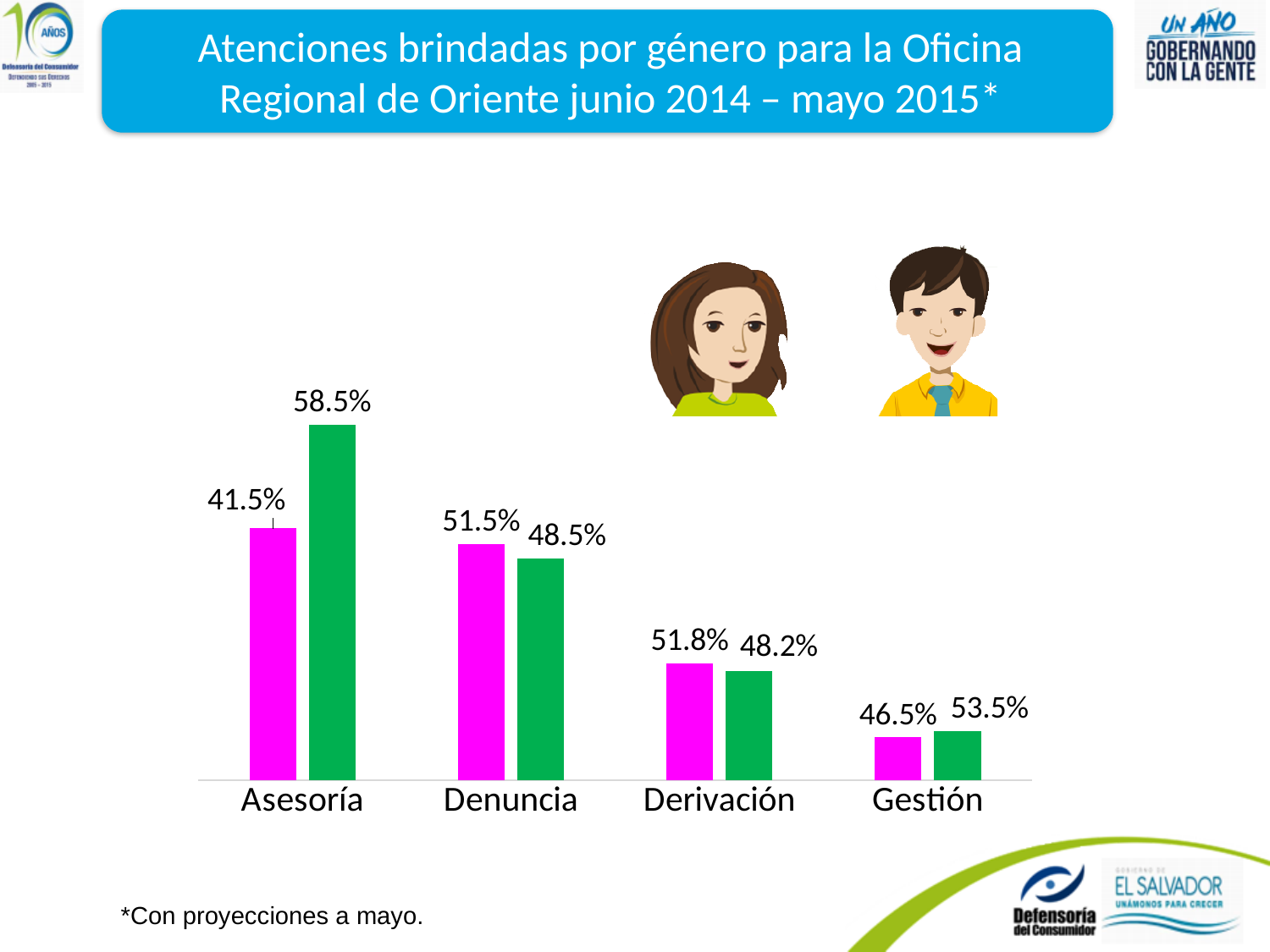
What kind of chart is shown on the slide? bar chart What is the value of the green bar for Asesoría? 58.5% What is the value of the green bar for Gestión? 53.5% What is the total of the magenta and green values for Derivación? 100% What is the value of the magenta bar for Derivación? 51.8% Which category has the lowest magenta bar? Gestión For Gestión, which bar is larger, the magenta or the green one? green What is the difference between the magenta and green bars for Denuncia? 3% What is the difference between the green and magenta bars for Asesoría? 17% Which category has the highest green bar? Asesoría How many categories are shown on the x axis? 4 What is the value of the magenta bar for Asesoría? 41.5%